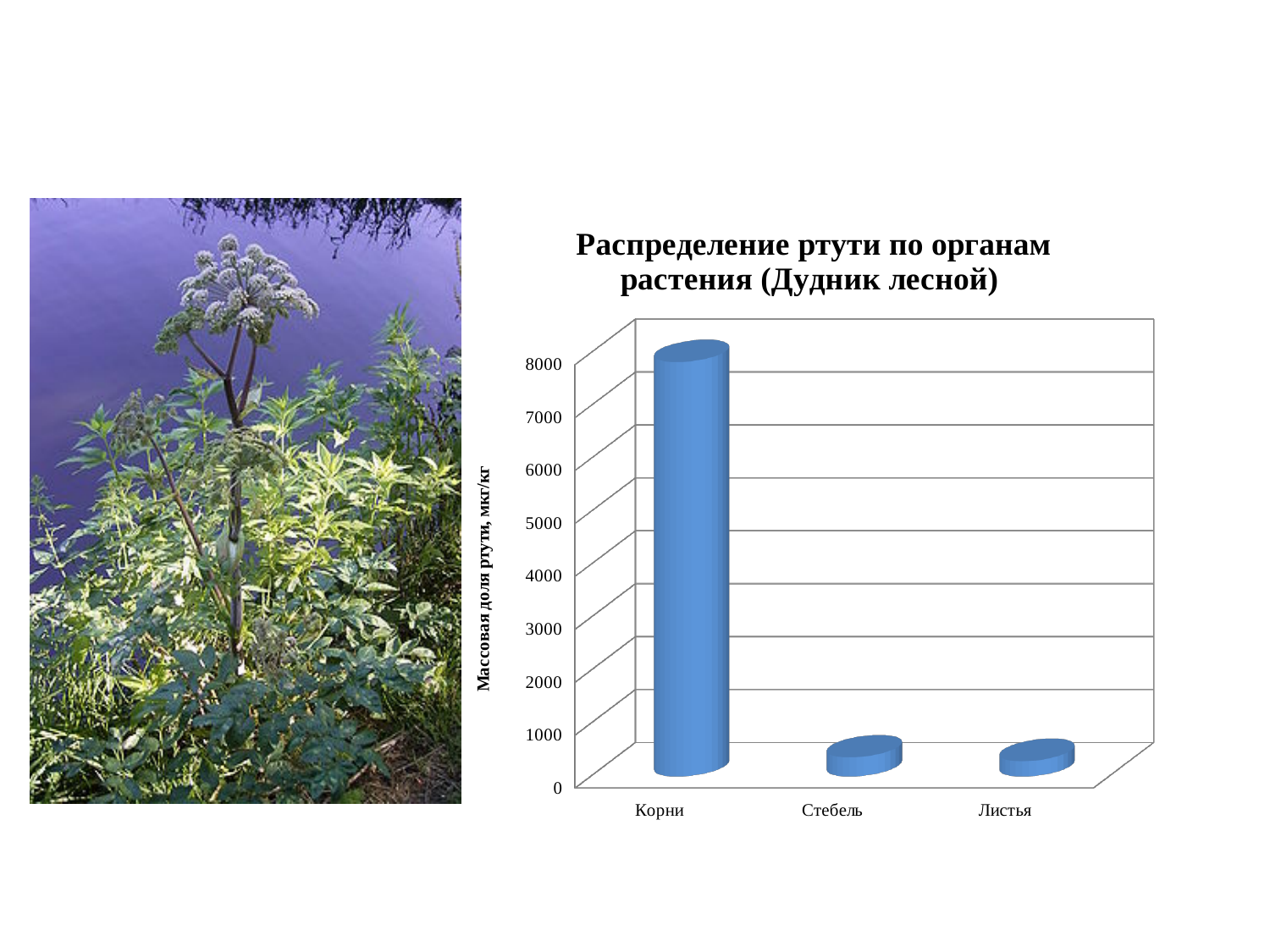
Is the value for Стебель greater or less than 1000? less Which is larger, the value for Корни or the value for Стебель? Корни Is the value for Корни greater or less than 7000? greater Is the value for Стебель greater or less than 2000? less What is the label of the vertical axis of the chart? Массовая доля ртути, мкг/кг How many categories are shown on the x axis of the chart? 3 Which is larger, the value for Корни or the value for Листья? Корни What kind of chart is shown on the slide? bar chart Which category has the highest value in the chart? Корни What is the title of the chart? Распределение ртути по органам растения (Дудник лесной)